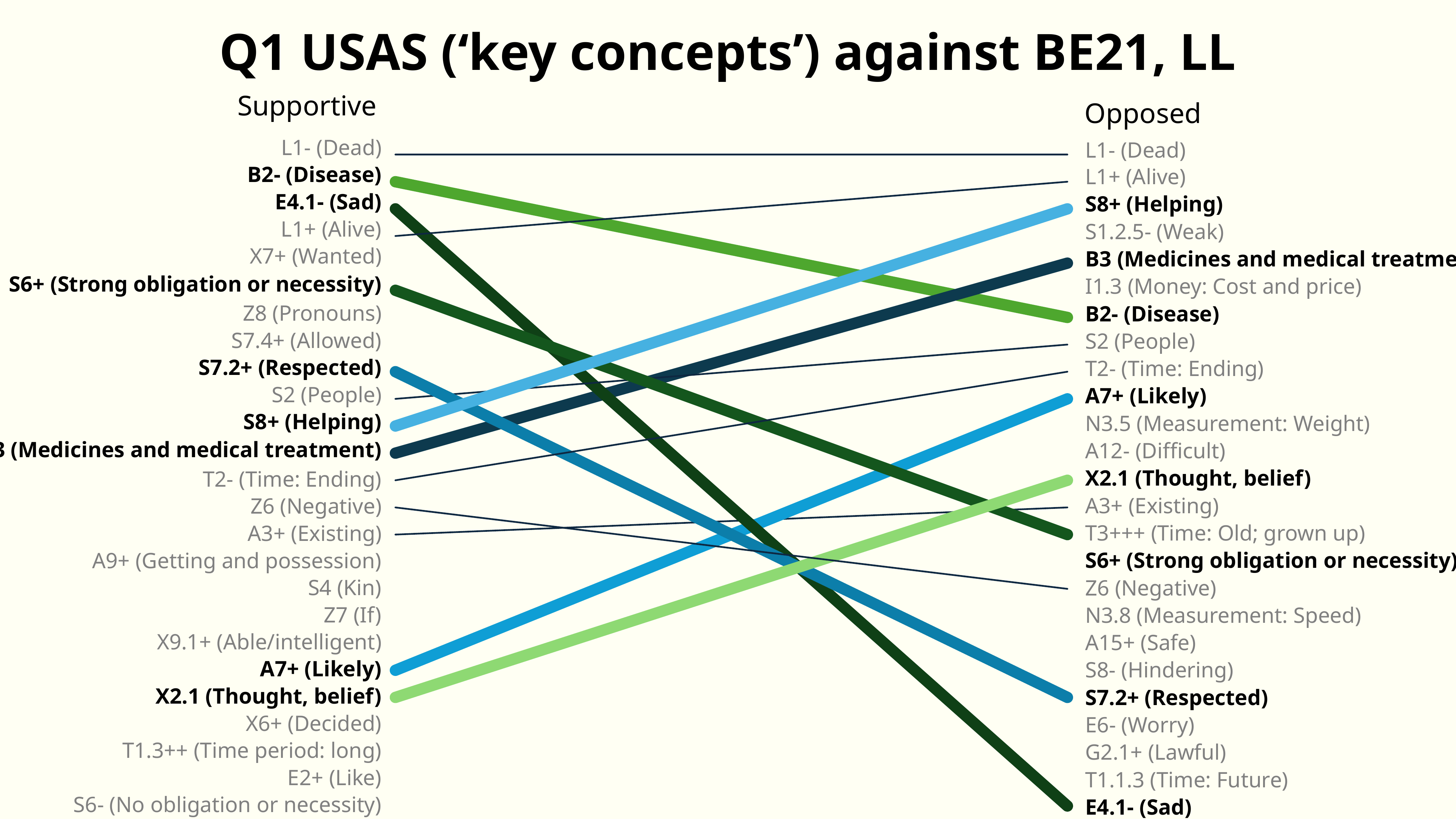
Which key concept is ranked at the top of the Supportive list? L1- (Dead) Which key concept is ranked at the top of the Opposed list? L1- (Dead) How many key concepts are listed in the Supportive column? 25 What rank does E4.1- (Sad) hold in the Supportive list? 3rd What rank does B2- (Disease) hold in the Opposed list? 7th What kind of chart is shown on the slide? Slope chart Does E4.1- (Sad) move up or down in rank from the Supportive list to the Opposed list? Down Which key concept is ranked at the bottom of the Supportive list? S6- (No obligation or necessity) Which key concept is ranked at the bottom of the Opposed list? E4.1- (Sad) What is the title of the chart? Q1 USAS ('key concepts') against BE21, LL Does S8+ (Helping) move up or down in rank from the Supportive list to the Opposed list? Up In the Opposed list, which is ranked higher: S8+ (Helping) or S7.2+ (Respected)? S8+ (Helping)